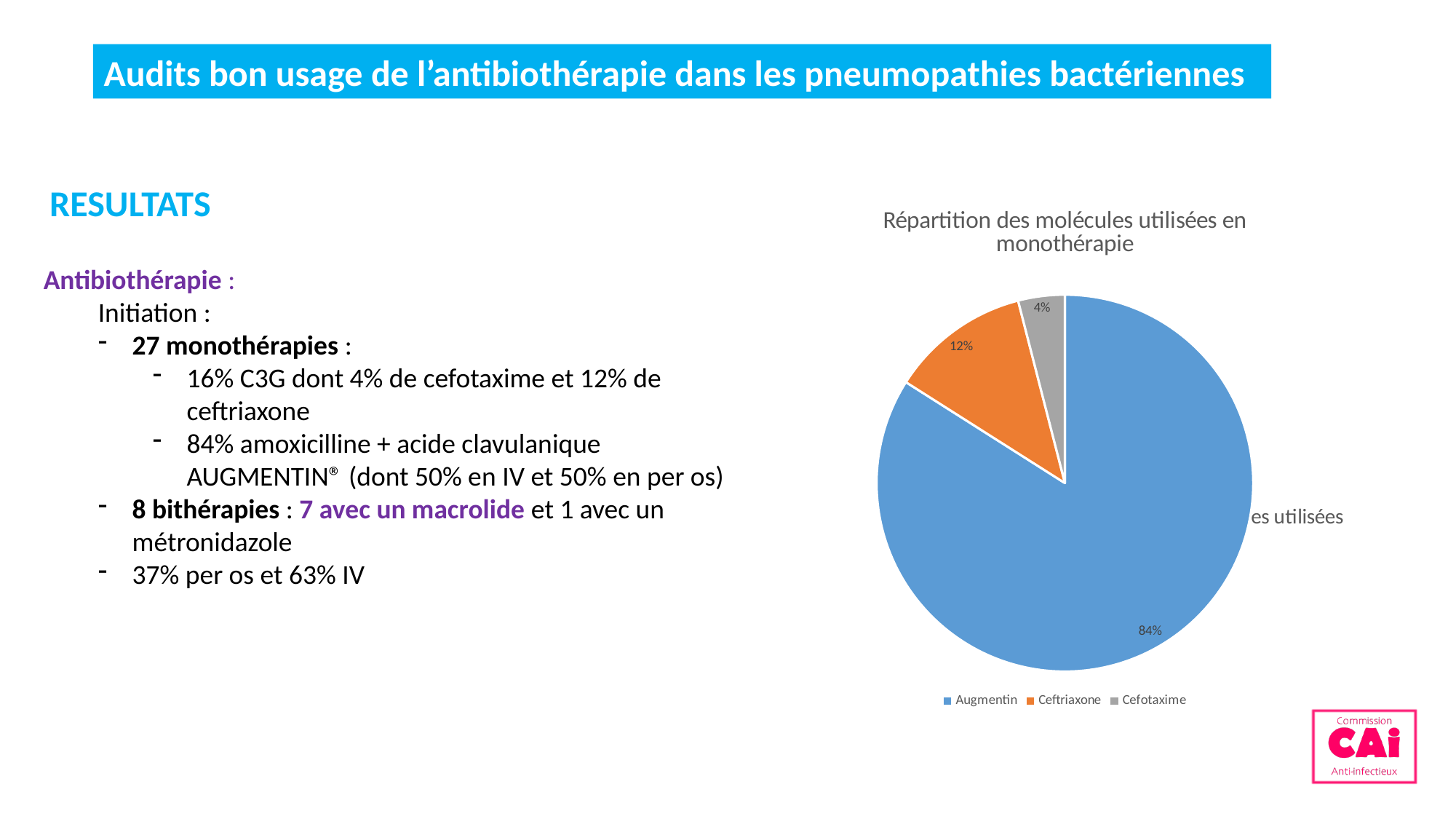
Which molecule has the largest slice of the pie? Augmentin Which slice is larger, Ceftriaxone or Cefotaxime? Ceftriaxone What share of the pie does Ceftriaxone represent? 12% Which molecule has the smallest slice of the pie? Cefotaxime What share of the pie does Augmentin represent? 84% How many slices does the pie chart have? 3 What share of the pie does Cefotaxime represent? 4% What is the difference in percentage points between the Ceftriaxone and Cefotaxime slices? 8 What kind of chart is shown on the slide? pie chart What is the title of the pie chart? Répartition des molécules utilisées en monothérapie How many entries does the legend list? 3 What colour is the Augmentin slice in the pie chart? blue